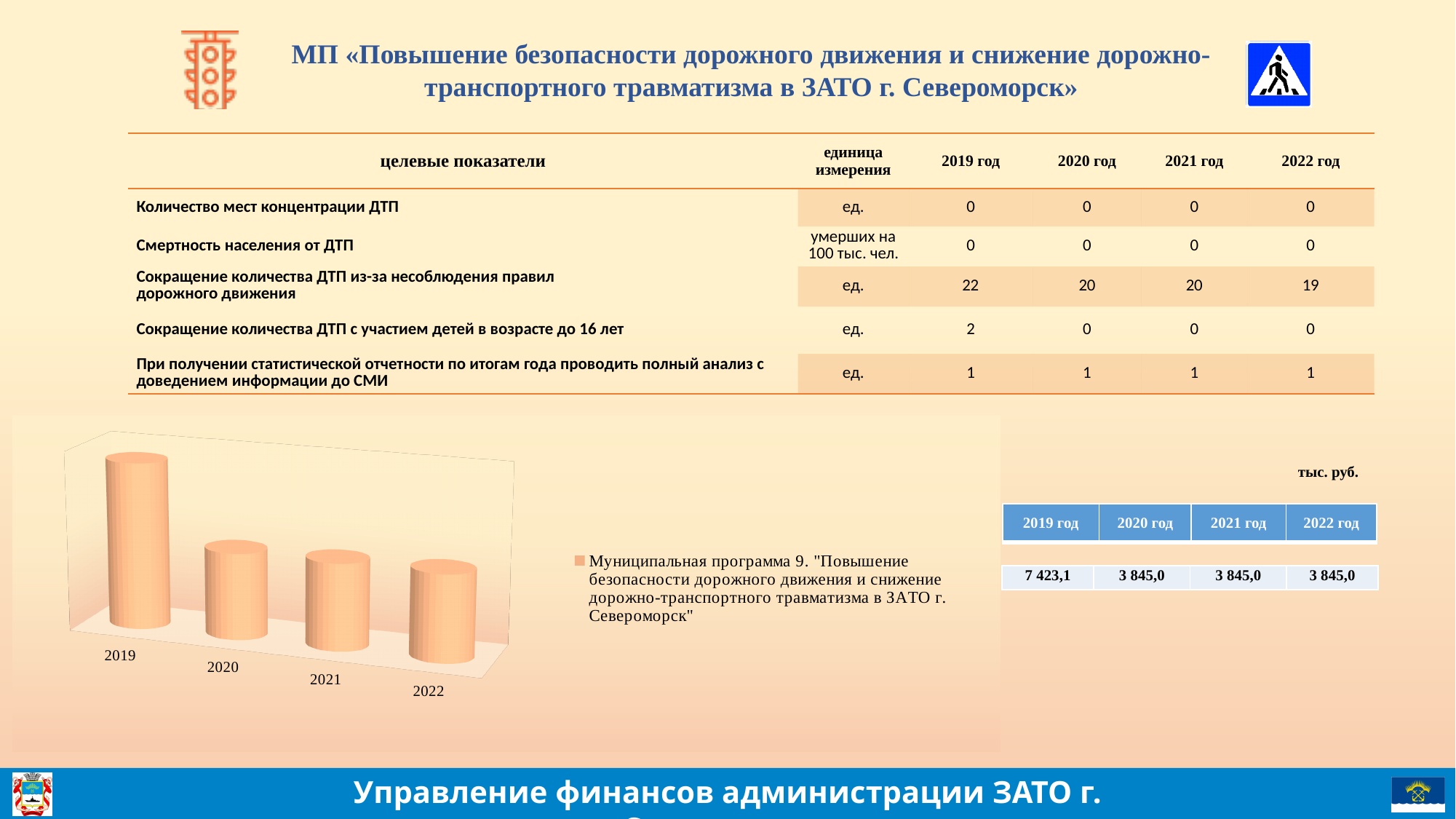
How many categories (years) does the bar chart at the bottom of the slide show? 4 Which is larger in the bar chart, the value for 2019 or the value for 2022? 2019 How many series does the legend of the bar chart list? 1 Which year has the highest bar in the bar chart? 2019 Do the values in the bar chart rise or fall from 2019 to 2020? fall What is the difference between the values for 2019 год and 2020 год in the data table next to the bar chart? 3 578,1 What kind of chart is shown at the bottom left of the slide? bar chart According to the data table next to the bar chart, what is the value for 2019 год? 7 423,1 What unit is stated above the data table next to the bar chart? тыс. руб. According to the data table next to the bar chart, what is the value for 2021 год? 3 845,0 What is the number of the municipal programme named in the legend of the bar chart? 9